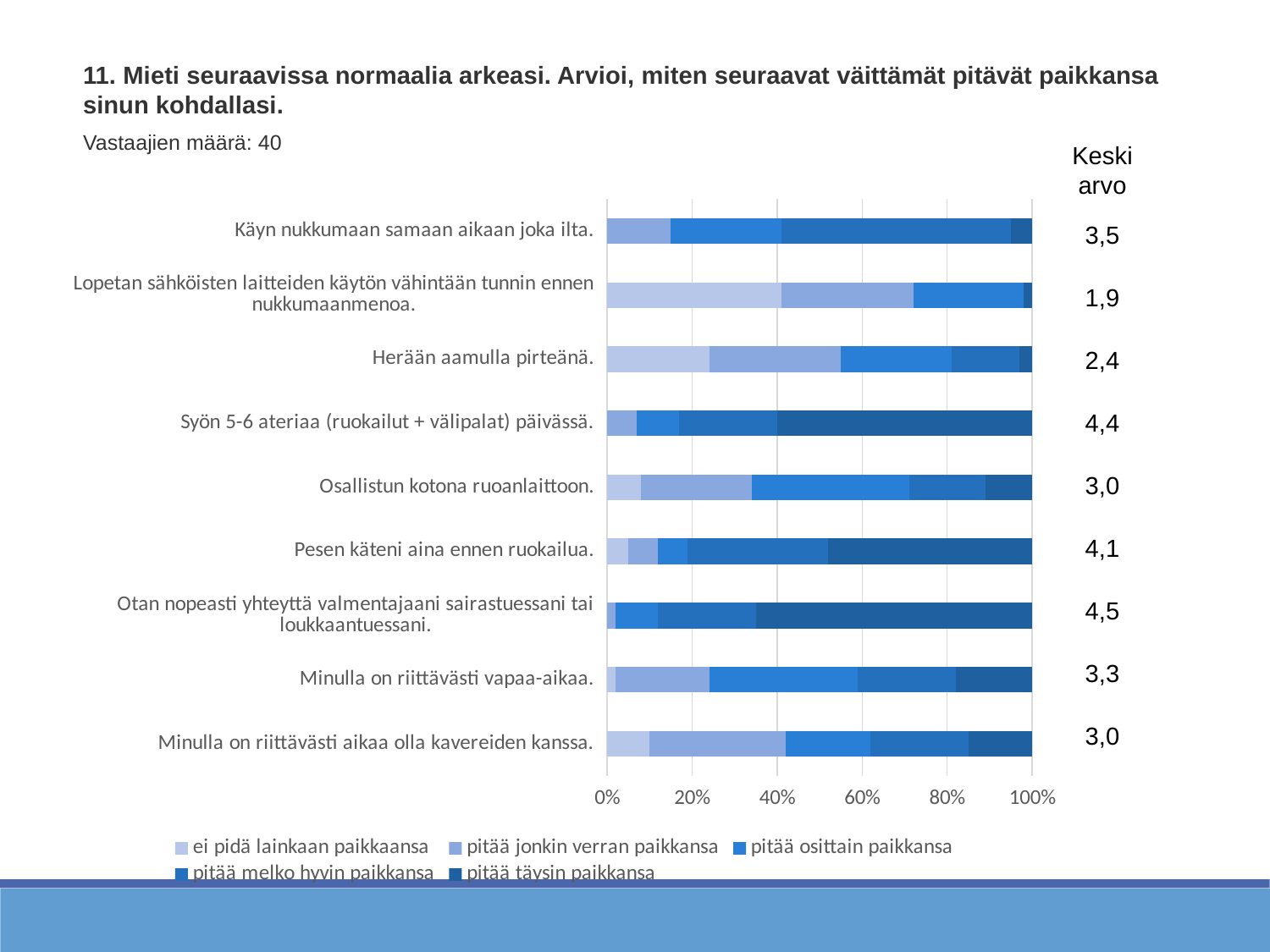
Is the "ei pidä lainkaan paikkaansa" share for "Lopetan sähköisten laitteiden käytön vähintään tunnin ennen nukkumaanmenoa." greater or less than 20%? greater What is the Keskiarvo (mean) shown for "Käyn nukkumaan samaan aikaan joka ilta."? 3,5 Is the "pitää täysin paikkansa" share for "Syön 5-6 ateriaa (ruokailut + välipalat) päivässä." greater or less than 40%? greater Which statement has the lowest Keskiarvo (mean) value? Lopetan sähköisten laitteiden käytön vähintään tunnin ennen nukkumaanmenoa. What is the Keskiarvo (mean) shown for "Syön 5-6 ateriaa (ruokailut + välipalat) päivässä."? 4,4 Which has the larger Keskiarvo value: "Minulla on riittävästi vapaa-aikaa." or "Osallistun kotona ruoanlaittoon."? Minulla on riittävästi vapaa-aikaa. Which statement has the highest Keskiarvo (mean) value? Otan nopeasti yhteyttä valmentajaani sairastuessani tai loukkaantuessani. How many respondents (Vastaajien määrä) does the slide report? 40 What is the difference between the Keskiarvo values for "Pesen käteni aina ennen ruokailua." and "Herään aamulla pirteänä."? 1,7 How many series does the chart legend list? 5 How many statements (categories) are plotted in the chart? 9 What kind of chart is shown on the slide? bar chart